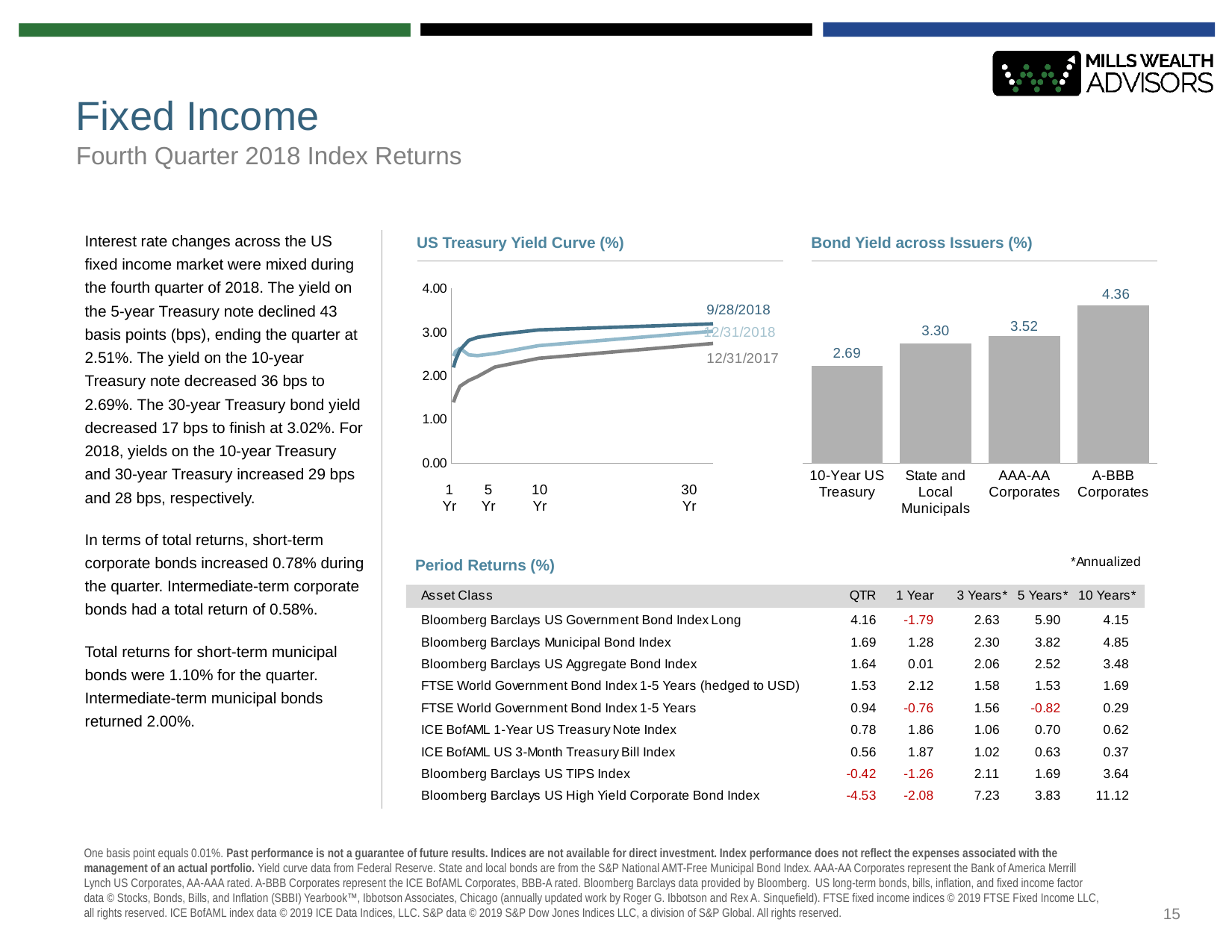
In the 'US Treasury Yield Curve (%)' chart, is the 12/31/2017 yield at 1 Yr greater or less than 2.00? less In the 'Bond Yield across Issuers (%)' chart, which issuer has the highest yield? A-BBB Corporates How many bars are shown in the 'Bond Yield across Issuers (%)' chart? 4 In the 'Bond Yield across Issuers (%)' chart, what is the value for State and Local Municipals? 3.30 In the 'Bond Yield across Issuers (%)' chart, which issuer has the lowest yield? 10-Year US Treasury In the 'Bond Yield across Issuers (%)' chart, what is the difference between the A-BBB Corporates yield and the 10-Year US Treasury yield? 1.67 What type of chart is the 'Bond Yield across Issuers (%)' chart? Bar chart In the 'Bond Yield across Issuers (%)' chart, what is the value for AAA-AA Corporates? 3.52 How many series (dates) are plotted in the 'US Treasury Yield Curve (%)' chart? 3 In the 'Bond Yield across Issuers (%)' chart, which is larger: the yield for State and Local Municipals or for AAA-AA Corporates? AAA-AA Corporates What type of chart is the 'US Treasury Yield Curve (%)' chart? Line chart In the 'Bond Yield across Issuers (%)' chart, what is the value for A-BBB Corporates? 4.36